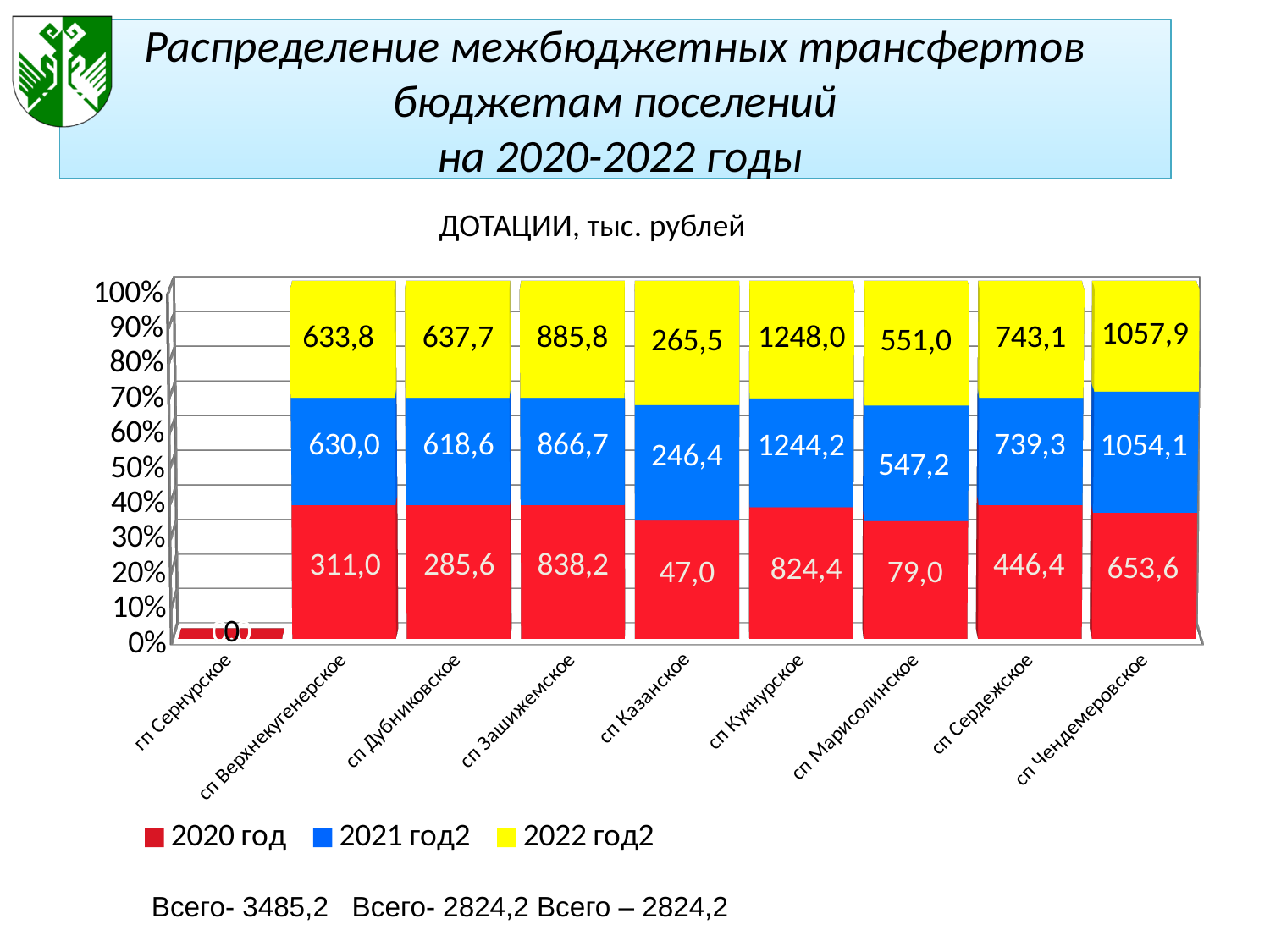
What is the total of the three series for сп Казанское? 558,9 How many series does the legend list? 3 What is the title shown above the chart? ДОТАЦИИ, тыс. рублей What is the 2021 год2 value for сп Марисолинское? 547,2 Which is larger: the 2020 год value for сп Сердежское or for сп Дубниковское? сп Сердежское What is the difference between the 2022 год2 values for сп Кукнурское and сп Казанское? 982,5 Which category has the lowest 2021 год2 value? гп Сернурское What is the 2020 год value for сп Зашижемское? 838,2 What kind of chart is shown? stacked bar chart How many categories are shown on the x axis? 9 Which category has the highest 2022 год2 value? сп Кукнурское What is the 2022 год2 value for сп Чендемеровское? 1057,9